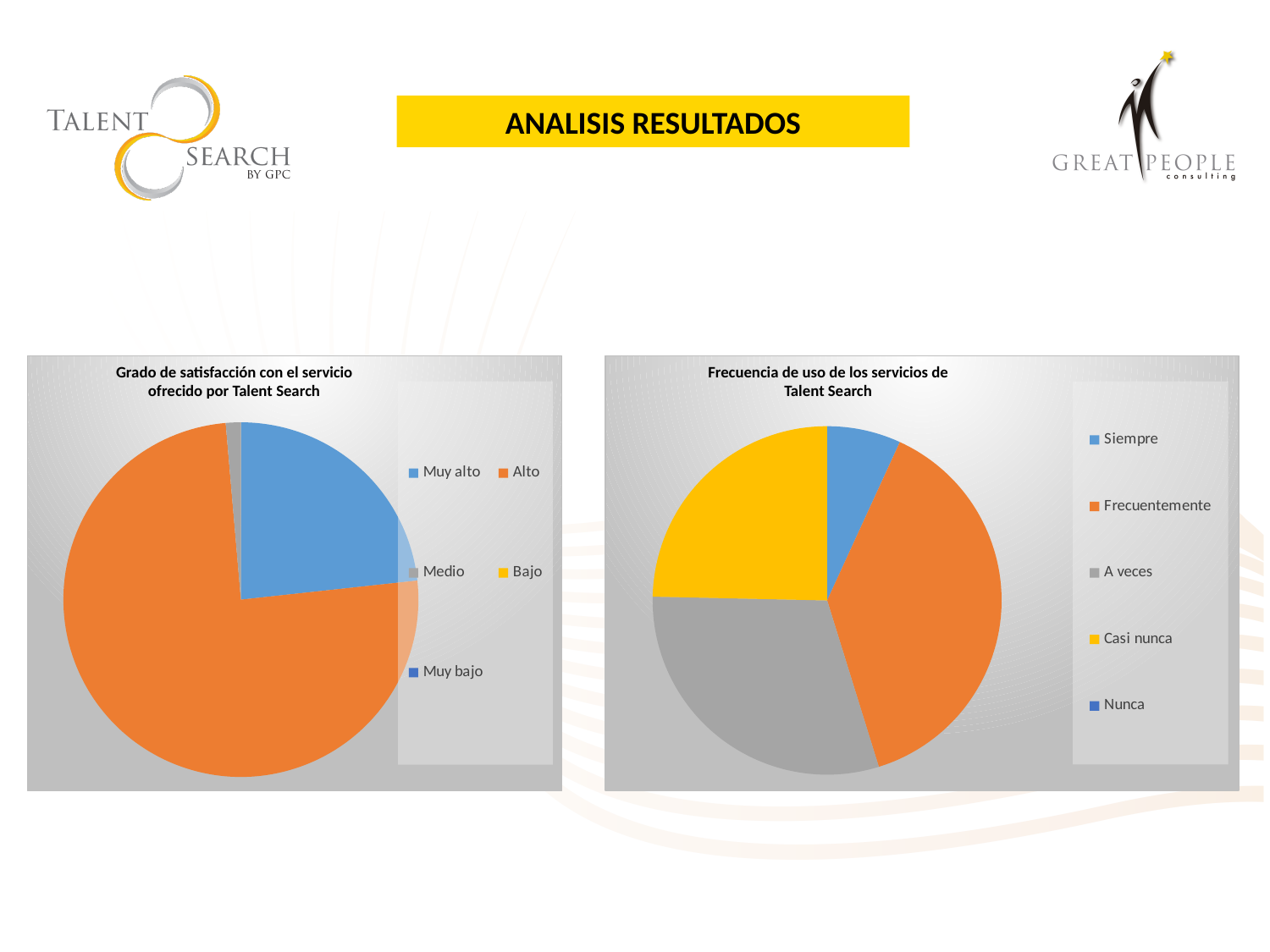
In the 'Frecuencia de uso de los servicios de Talent Search' chart, what colour is the Casi nunca slice? Yellow How many categories does the legend of the 'Grado de satisfacción con el servicio ofrecido por Talent Search' chart list? 5 In the 'Frecuencia de uso de los servicios de Talent Search' chart, which visible slice is the smallest? Siempre In the 'Grado de satisfacción con el servicio ofrecido por Talent Search' chart, which category has the largest slice? Alto In the 'Frecuencia de uso de los servicios de Talent Search' chart, which category has the largest slice? Frecuentemente In the 'Frecuencia de uso de los servicios de Talent Search' chart, which slice is larger, A veces or Casi nunca? A veces What kind of chart is the 'Frecuencia de uso de los servicios de Talent Search' chart? Pie chart What kind of chart is the 'Grado de satisfacción con el servicio ofrecido por Talent Search' chart? Pie chart How many categories does the legend of the 'Frecuencia de uso de los servicios de Talent Search' chart list? 5 In the 'Frecuencia de uso de los servicios de Talent Search' chart, which slice is larger, Siempre or Frecuentemente? Frecuentemente In the 'Grado de satisfacción con el servicio ofrecido por Talent Search' chart, which visible slice is the smallest? Medio In the 'Grado de satisfacción con el servicio ofrecido por Talent Search' chart, which slice is larger, Muy alto or Medio? Muy alto